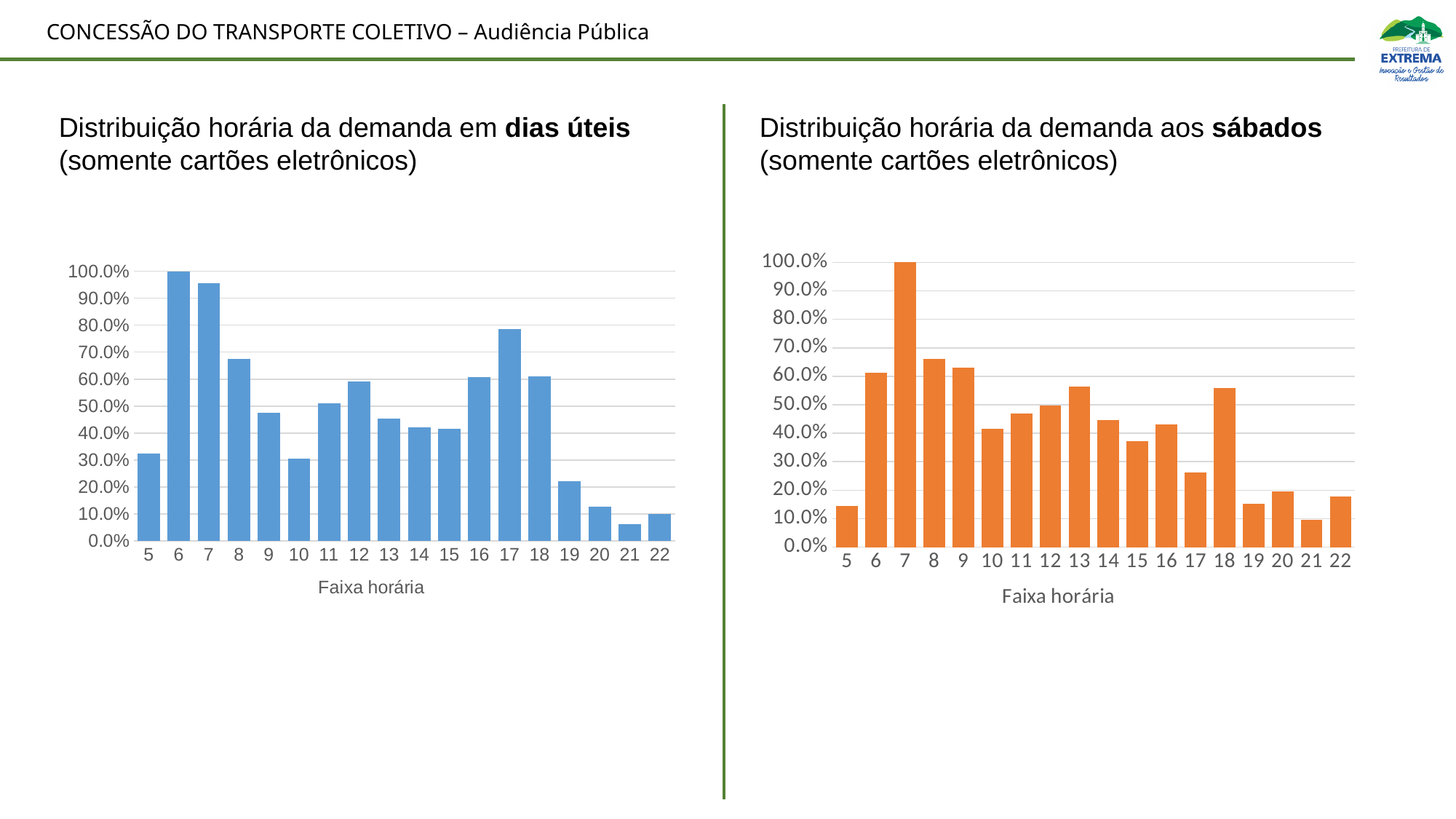
In the left chart (dias úteis), what is the value for hour 6? 100.0% In the right chart (sábados), which is larger, the value for hour 6 or hour 10? hour 6 In the left chart (dias úteis), which hour has the highest value? 6 In the right chart (sábados), is the value for hour 17 greater or less than 30.0%? less What kind of chart is the right chart (sábados)? bar chart In the right chart (sábados), which hour has the lowest value? 21 In the left chart (dias úteis), is the value for hour 17 greater or less than 70.0%? greater In the left chart (dias úteis), which is larger, the value for hour 17 or hour 18? hour 17 In the left chart (dias úteis), which hour has the lowest value? 21 How many hour categories are shown on the x axis of the left chart (dias úteis)? 18 In the right chart (sábados), which hour has the highest value? 7 In the right chart (sábados), what is the value for hour 7? 100.0%